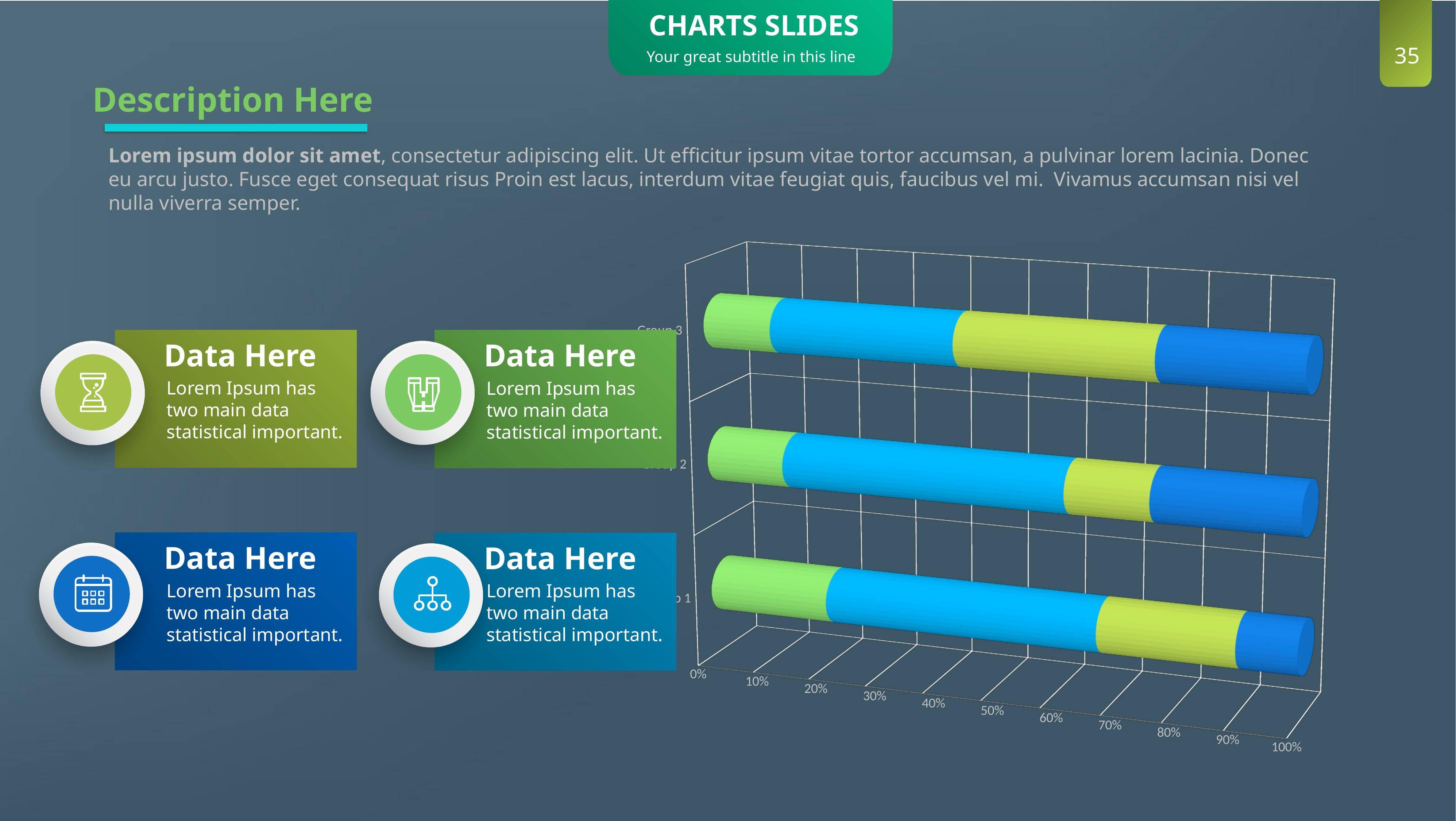
What is the label of the top bar in the chart? Group 3 In the middle bar, which segment is wider: the green segment or the light blue segment? light blue How many bars does the chart contain? 3 What is the highest value shown on the chart's percentage axis? 100% In the bottom bar, which segment is wider: the light blue segment or the dark blue segment? light blue In the bottom bar, which segment is wider: the green segment or the light blue segment? light blue How many coloured segments make up each bar in the chart? 4 In the middle bar, which coloured segment is the widest? light blue What kind of chart is shown on the slide? bar chart